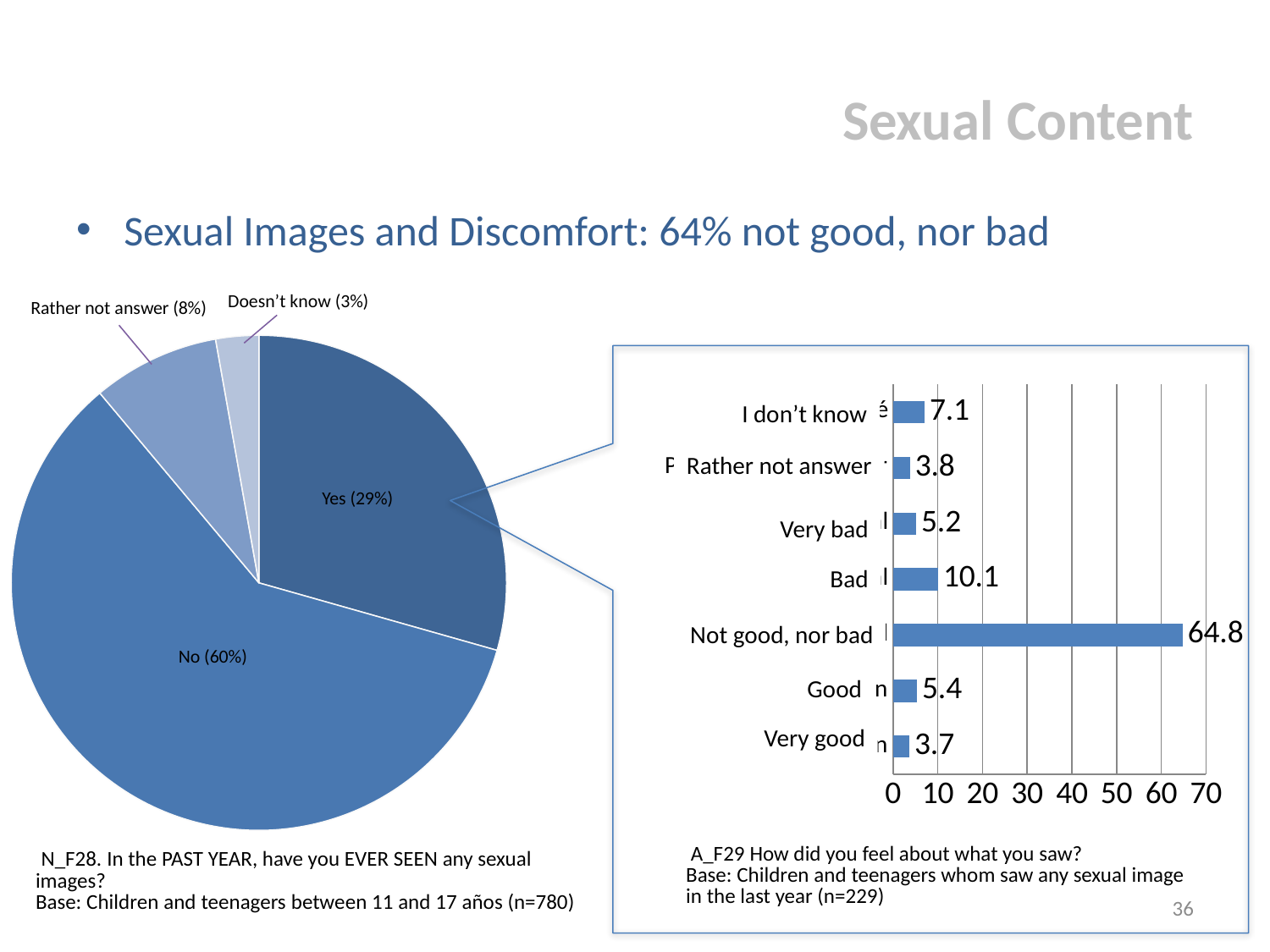
In the bar chart on the right, which is larger, Very bad or Good? Good In the bar chart on the right, what is the value for Bad? 10.1 In the pie chart on the left, what share of respondents answered Yes? 29% In the bar chart on the right, which category has the highest value? Not good, nor bad In the bar chart on the right, what is the value for Not good, nor bad? 64.8 What type of chart is shown on the right side of the slide? Bar chart In the bar chart on the right, which category has the lowest value? Very good In the pie chart on the left, which category has the smallest slice? Doesn't know In the pie chart on the left, how many slices are there? 4 In the pie chart on the left, what is the difference in percentage points between No and Yes? 31 In the pie chart on the left, what share of respondents answered No? 60% In the bar chart on the right, how many categories are plotted? 7